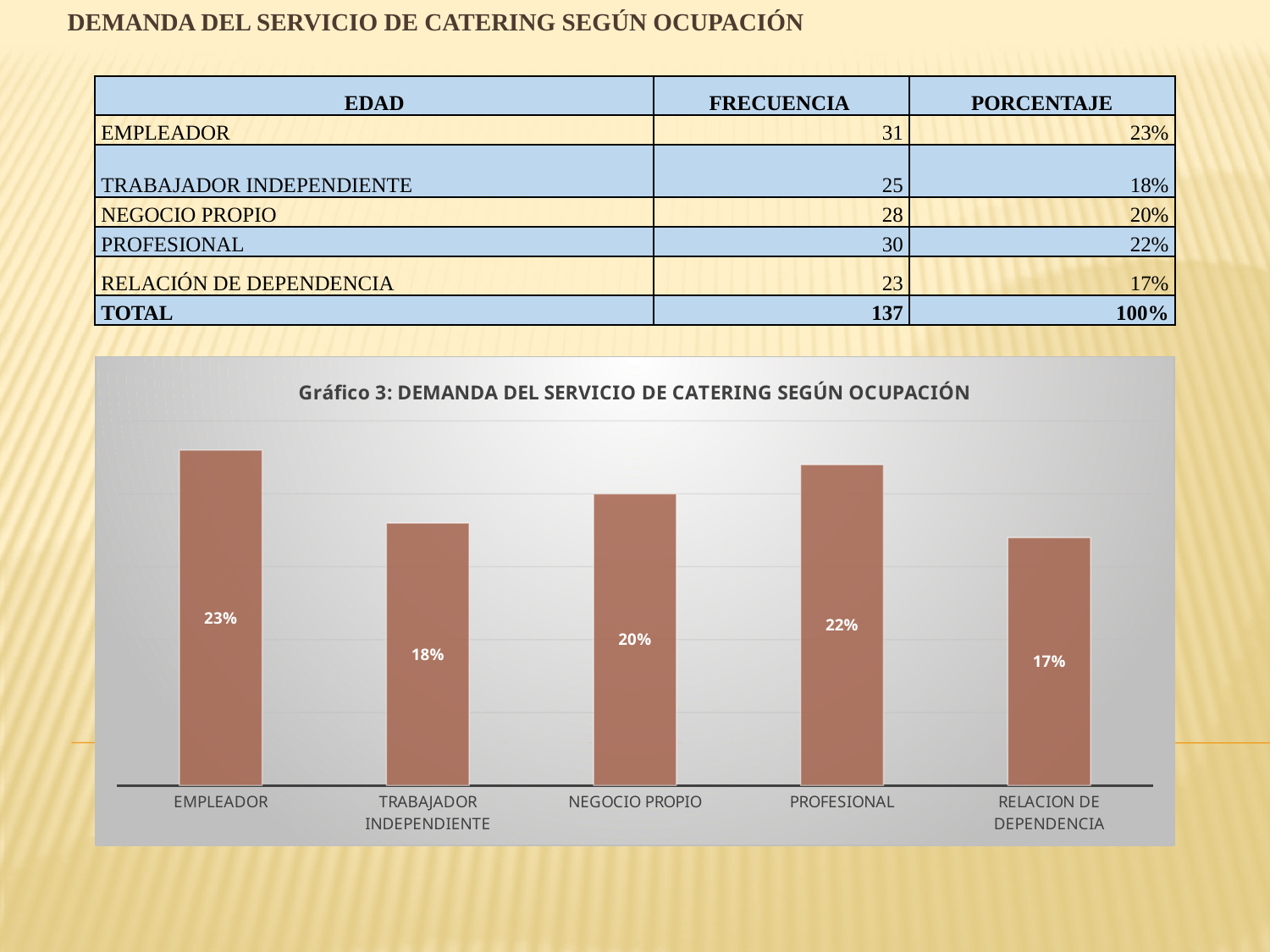
Which category has the highest value in the chart? EMPLEADOR What is the difference between the values for EMPLEADOR and RELACION DE DEPENDENCIA? 6% How many categories are shown in the chart? 5 What is the value for RELACION DE DEPENDENCIA in the chart? 17% Which category has the lowest value in the chart? RELACION DE DEPENDENCIA What is the difference between the values for PROFESIONAL and TRABAJADOR INDEPENDIENTE? 4% What kind of chart is shown on the slide? Bar chart What is the value for NEGOCIO PROPIO in the chart? 20% Which is larger, the value for PROFESIONAL or the value for NEGOCIO PROPIO? PROFESIONAL What is the title of the chart? Gráfico 3: DEMANDA DEL SERVICIO DE CATERING SEGÚN OCUPACIÓN What is the value for TRABAJADOR INDEPENDIENTE in the chart? 18% What is the value for EMPLEADOR in the chart? 23%